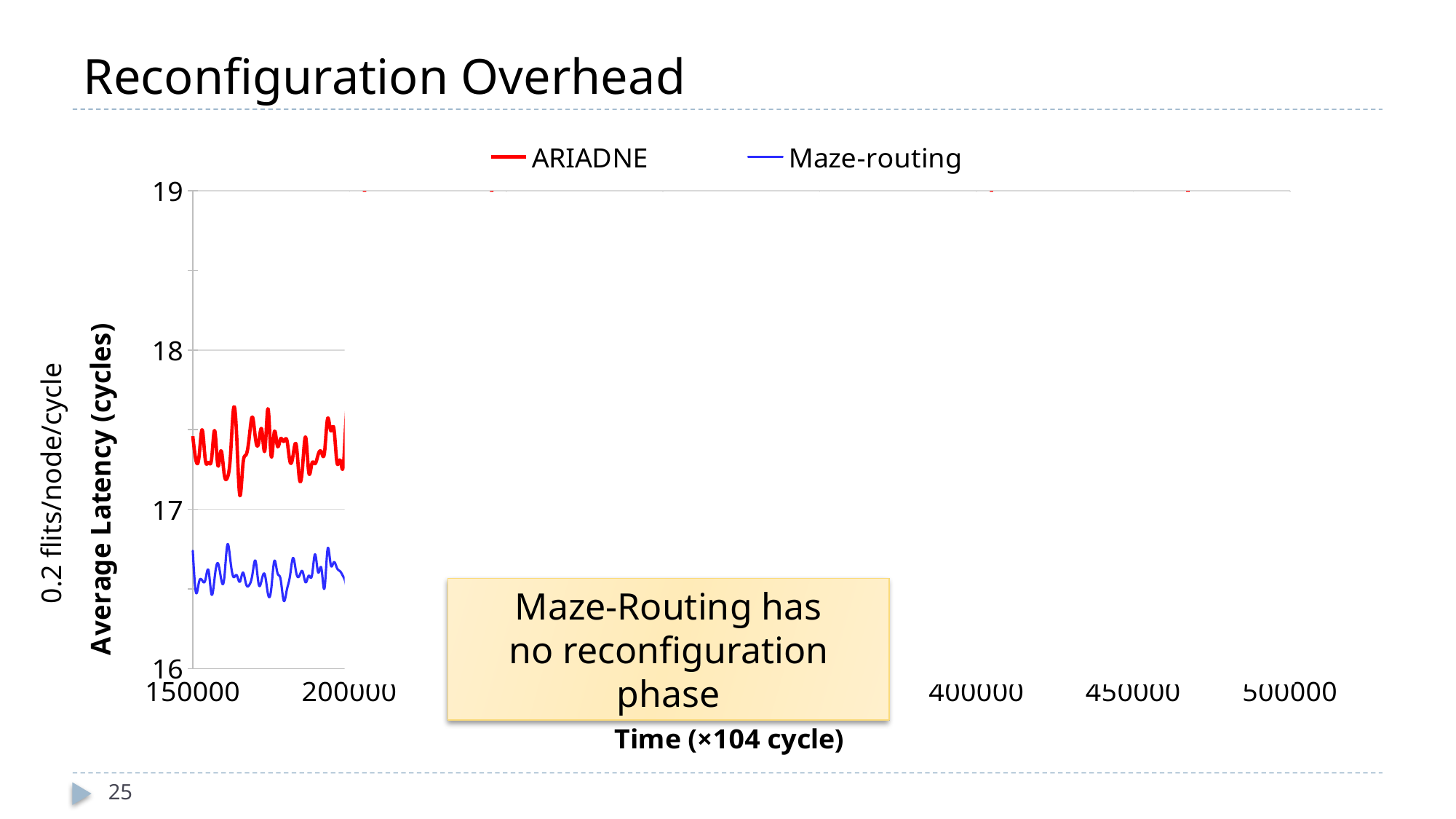
Is the average latency of ARIADNE in the plotted region greater or less than 17? greater What is the label of the vertical axis of the chart? Average Latency (cycles) What is the first tick value shown on the x axis of the chart? 150000 Which series has the higher average latency in the plotted region, ARIADNE or Maze-routing? ARIADNE Which two series are listed in the chart legend? ARIADNE and Maze-routing Is the average latency of ARIADNE in the plotted region greater or less than 18? less Which series has the lower average latency in the plotted region? Maze-routing What is the highest tick value shown on the y axis of the chart? 19 How many series does the chart legend list? 2 Is the average latency of Maze-routing in the plotted region greater or less than 17? less What kind of chart is shown on the slide? line chart